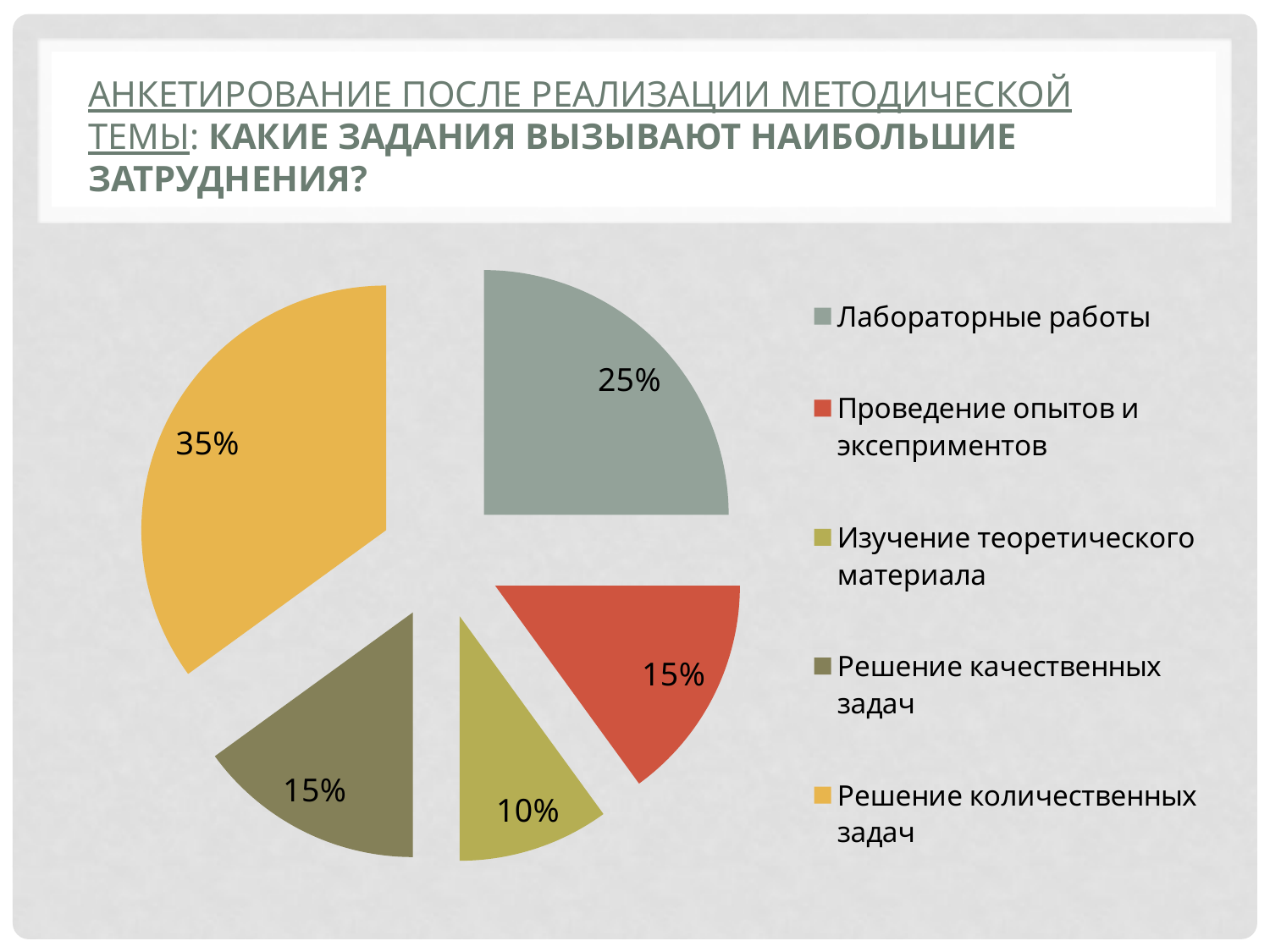
What is the difference between the shares for Решение количественных задач and Лабораторные работы? 10% What share of the pie is Лабораторные работы? 25% What colour is the slice for Решение количественных задач? yellow What share of the pie is Изучение теоретического материала? 10% Which is larger: the share for Лабораторные работы or the share for Решение качественных задач? Лабораторные работы Which category has the smallest slice of the pie? Изучение теоретического материала Which category has the largest slice of the pie? Решение количественных задач What share of the pie is Проведение опытов и эксеприментов? 15% What kind of chart is shown on the slide? pie chart How many slices does the pie chart have? 5